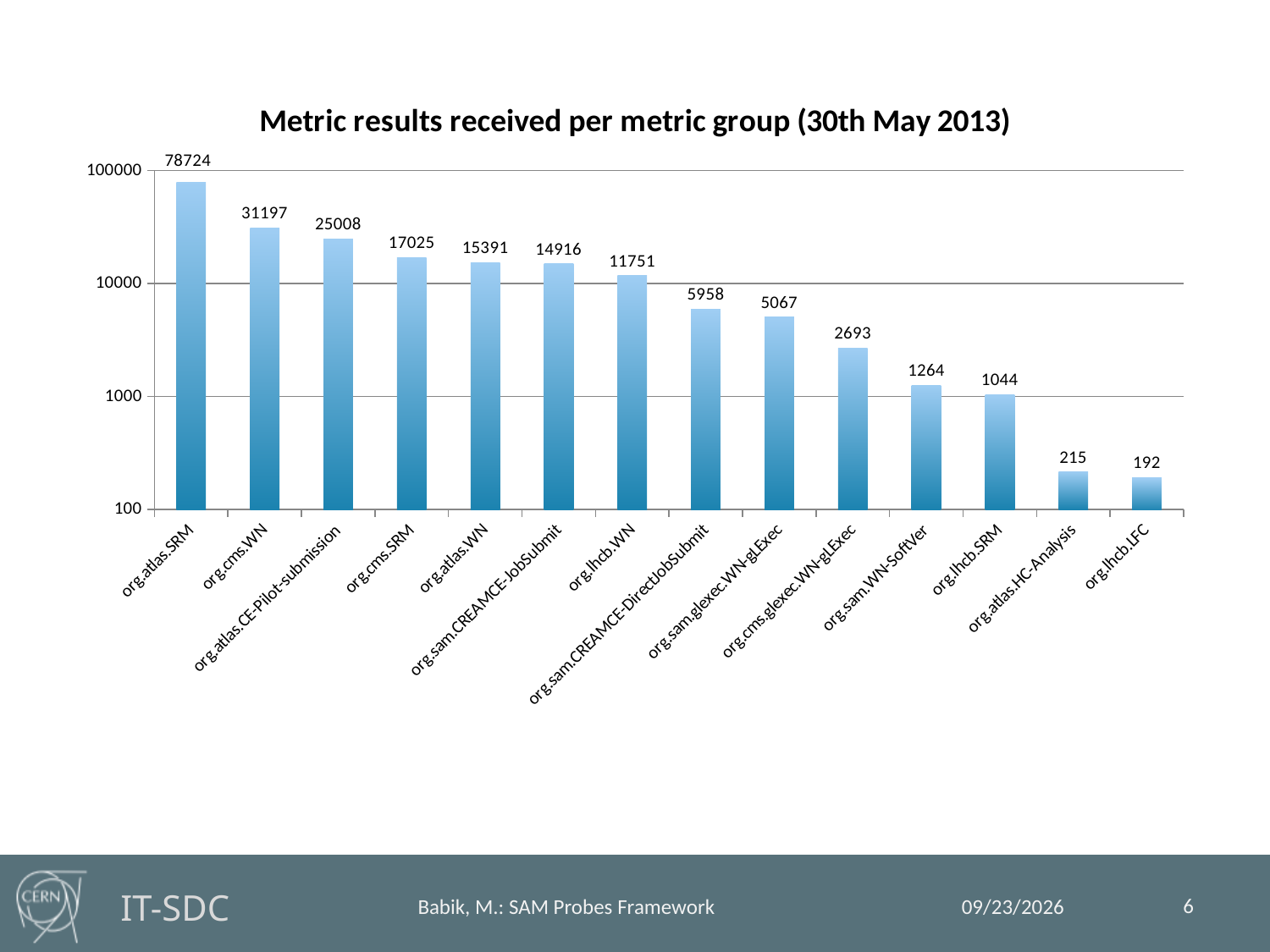
What is the value for org.atlas.SRM? 78724 What is the value for org.sam.CREAMCE-DirectJobSubmit? 5958 How many metric groups are shown on the chart? 14 Is the value for org.sam.WN-SoftVer greater or less than 1000? greater Which metric group has the lowest value? org.lhcb.LFC Which metric group has the highest value? org.atlas.SRM Do the values rise or fall from left to right along the x axis? fall What is the difference between the values for org.cms.WN and org.atlas.CE-Pilot-submission? 6189 Which is larger, the value for org.cms.SRM or the value for org.atlas.WN? org.cms.SRM What is the value for org.lhcb.LFC? 192 What kind of chart is shown on the slide? bar chart What is the title of the chart? Metric results received per metric group (30th May 2013)